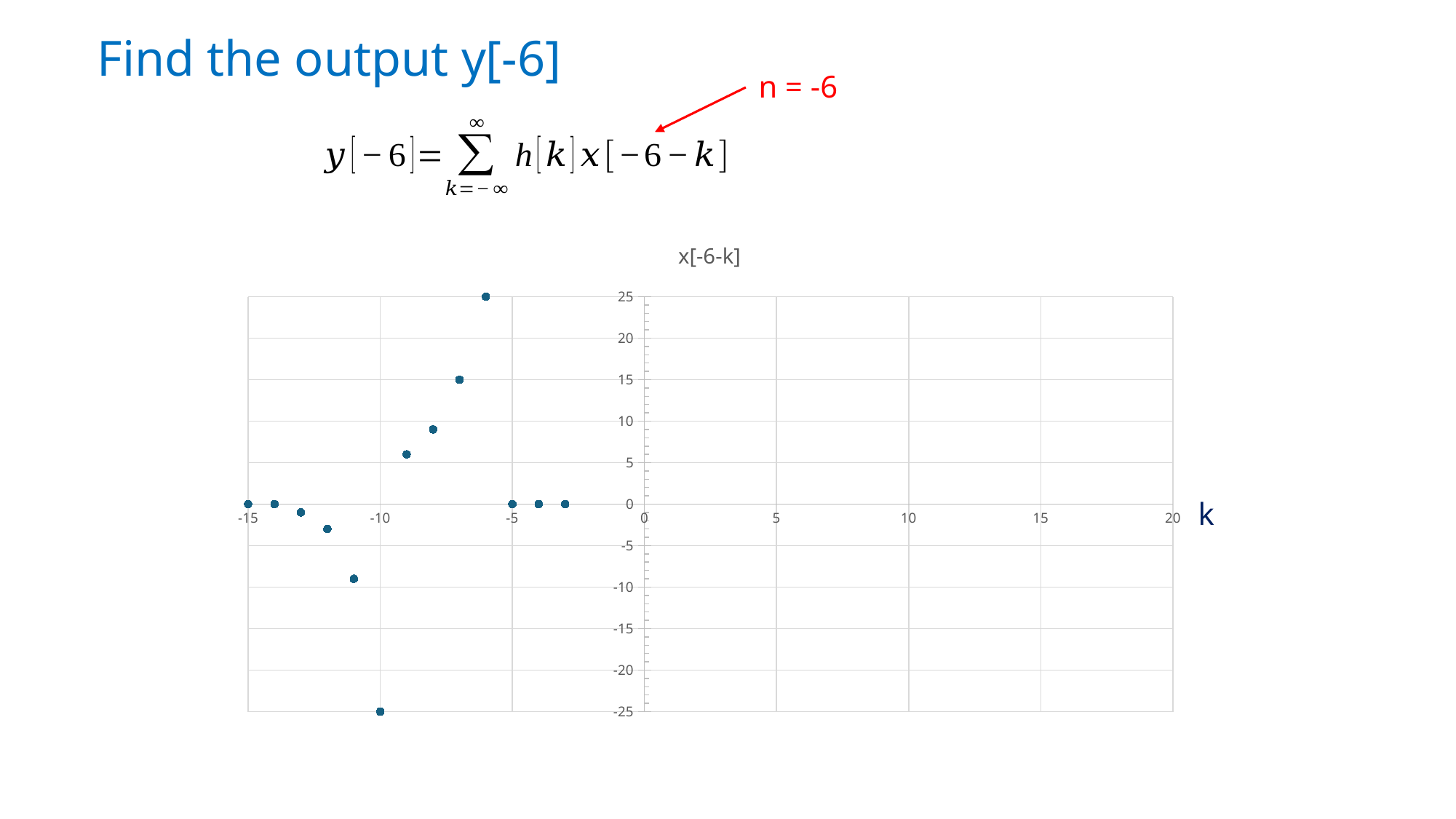
What kind of chart is shown on the slide? scatter chart What label is shown on the horizontal axis of the chart? k Is the plotted value at k = -8 greater or less than 5? greater Which has the larger plotted value, k = -7 or k = -9? k = -7 At which value of k does the plotted point reach its lowest value? -10 What is the plotted value at k = -10? -25 What is the plotted value at k = -7? 15 Is the plotted value at k = -11 greater or less than -5? less What is the title of the chart? x[-6-k] At which value of k does the plotted point reach its highest value? -6 What is the plotted value at k = -6? 25 What is the plotted value at k = -5? 0